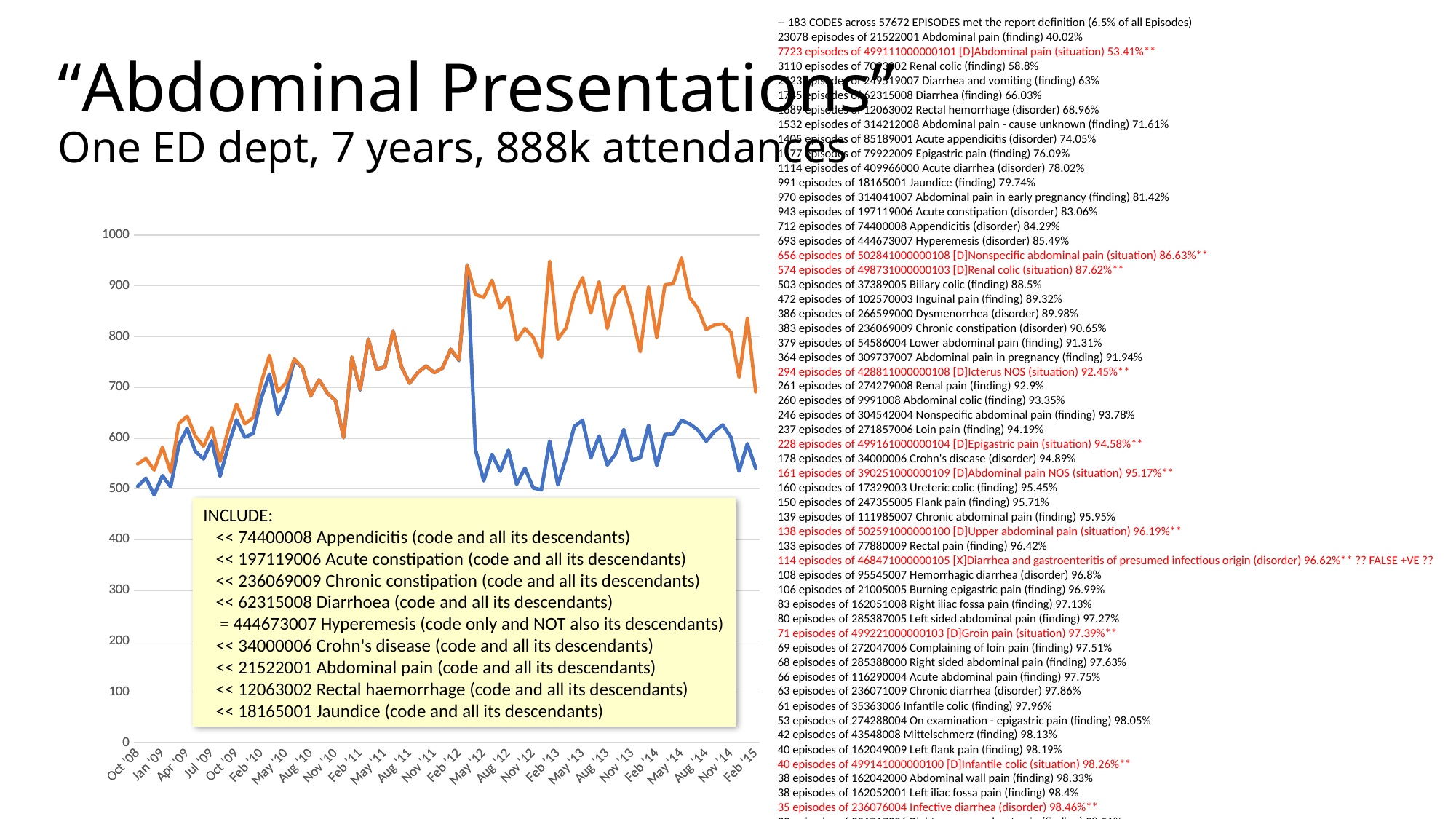
Is the value of the blue line at Feb '15 greater or less than 600? less Is the highest value reached by the orange line greater or less than 900? greater What kind of chart is shown on the slide? line chart What is the highest value shown on the y axis of the chart? 1000 Is the value of the orange line at Feb '15 greater or less than 800? less What is the first label on the x axis of the chart? Oct '08 From May '12 onwards, which line is higher, the blue line or the orange line? orange Between Oct '08 and Feb '10, do the two lines generally rise or fall? rise Does the blue line rise or fall sharply between Feb '12 and May '12? fall How many lines are plotted on the chart? 2